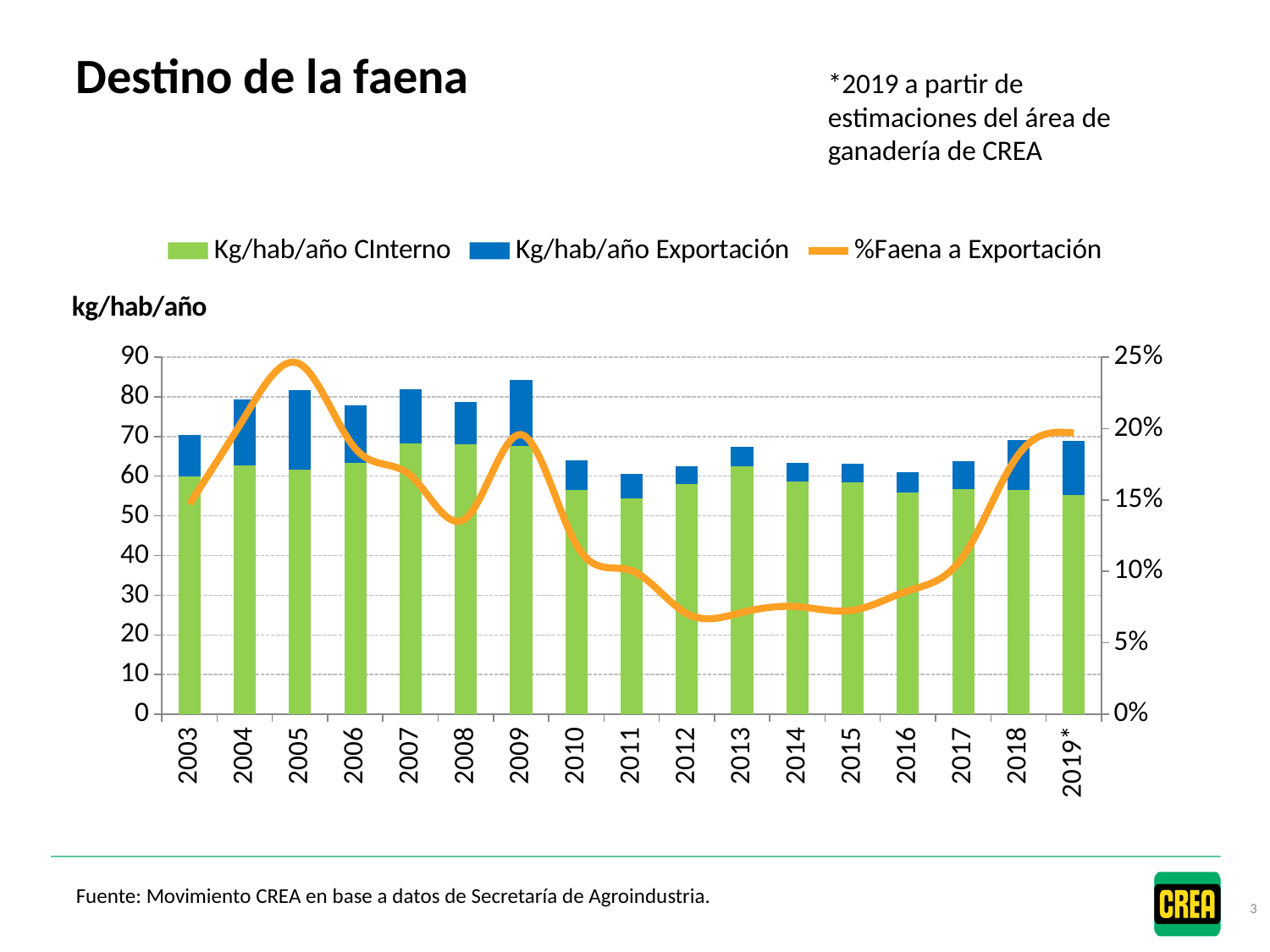
In which year does the %Faena a Exportación line reach its highest point? 2005 Is the %Faena a Exportación value for 2012 greater or less than 10%? less What is the label of the left vertical axis? kg/hab/año Is the total stacked bar for 2003 greater or less than 60 kg/hab/año? greater Does the %Faena a Exportación line rise or fall from 2005 to 2012? fall Which year has the higher %Faena a Exportación value, 2005 or 2013? 2005 What kind of chart is this? Stacked bar chart with a line Which year has the larger total stacked bar, 2009 or 2011? 2009 How many years are shown on the x axis? 17 Is the total stacked bar for 2011 greater or less than 70 kg/hab/año? less How many series does the legend list? 3